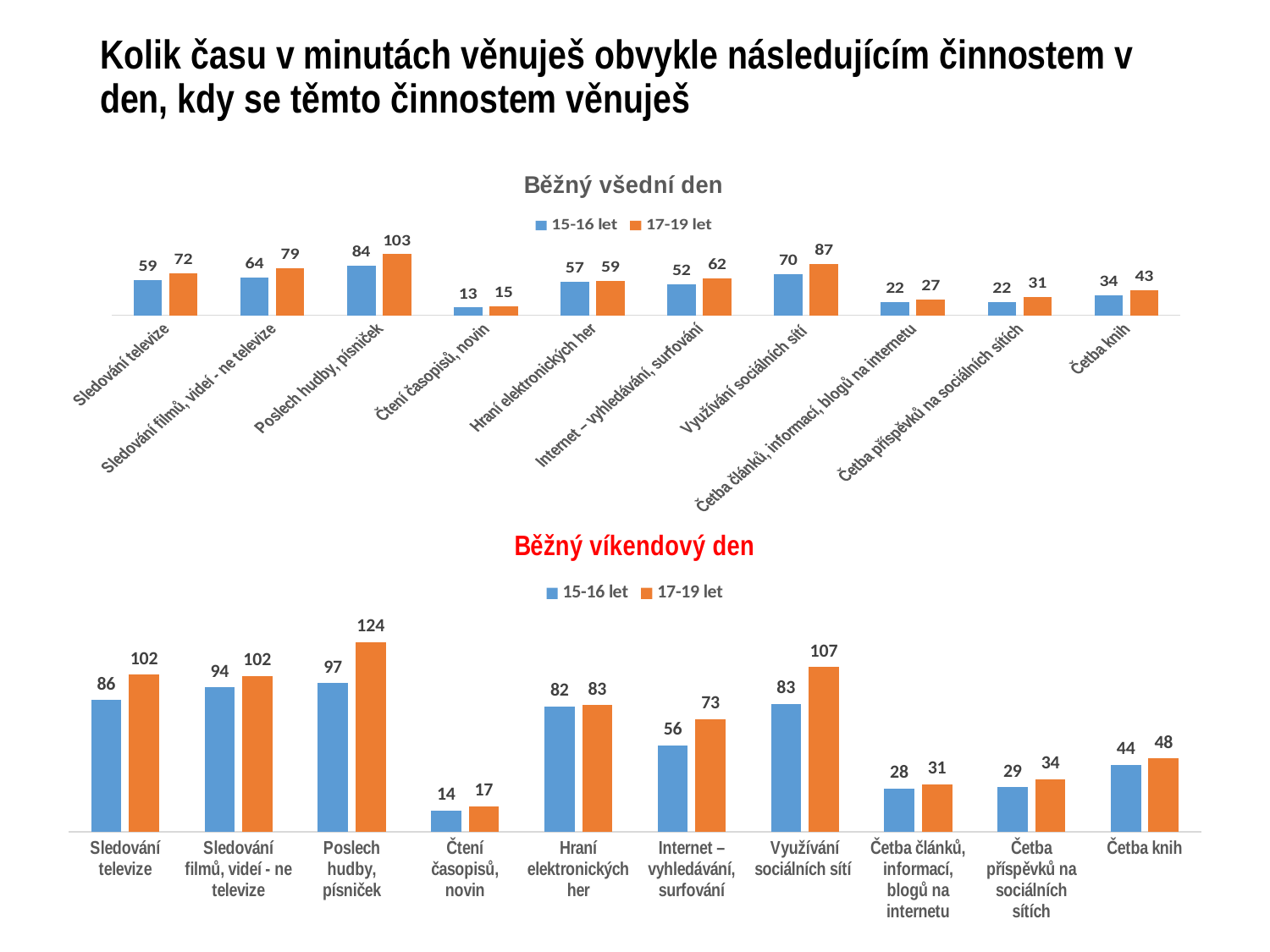
In the 'Běžný víkendový den' chart, which is larger: the 15-16 let value for Sledování filmů, videí - ne televize or the 15-16 let value for Využívání sociálních sítí? Sledování filmů, videí - ne televize In the 'Běžný všední den' chart, what is the difference between the 17-19 let and 15-16 let values for Využívání sociálních sítí? 17 In the 'Běžný víkendový den' chart, what is the difference between the 17-19 let and 15-16 let values for Poslech hudby, písniček? 27 How many categories are shown in the 'Běžný víkendový den' chart? 10 In the 'Běžný všední den' chart, what is the value for 17-19 let for Poslech hudby, písniček? 103 In the 'Běžný všední den' chart, which colour represents the 17-19 let series? Orange How many series does the legend of the 'Běžný všední den' chart list? 2 In the 'Běžný všední den' chart, which is larger for Sledování televize: 15-16 let or 17-19 let? 17-19 let In the 'Běžný všední den' chart, which category has the highest value for 15-16 let? Poslech hudby, písniček What kind of chart is the 'Běžný víkendový den' chart? Bar chart In the 'Běžný víkendový den' chart, which category has the lowest value for 17-19 let? Čtení časopisů, novin In the 'Běžný víkendový den' chart, what is the value for 15-16 let for Hraní elektronických her? 82